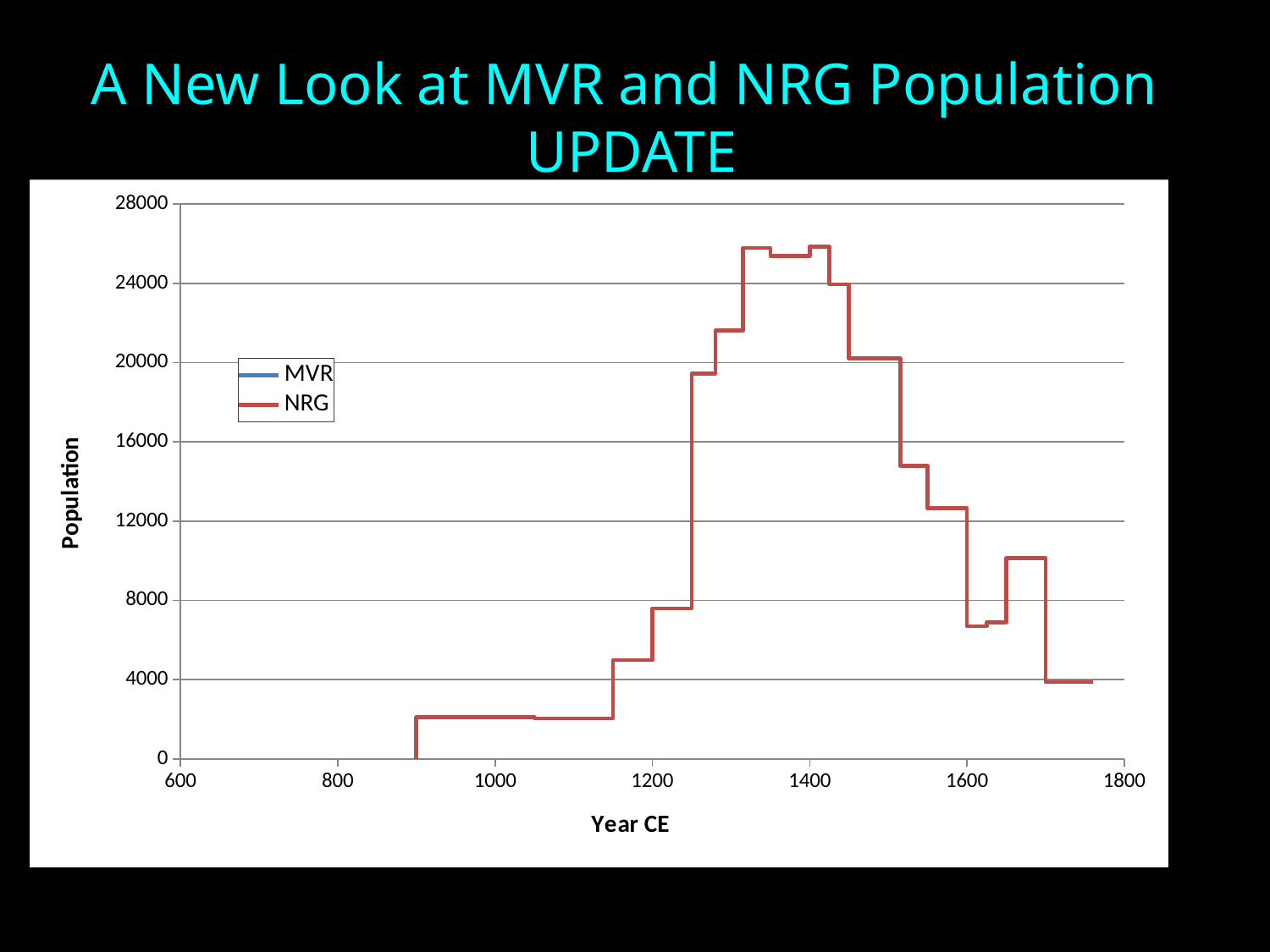
Does the NRG population rise or fall between the years 1420 and 1620? fall Does the NRG population rise or fall between the years 900 and 1350? rise What kind of chart is shown on the slide? line chart How many series does the legend list? 2 Is the NRG population higher around the year 1300 or around the year 1600? 1300 Is the NRG population around the year 1620 greater or less than 8000? less Is the NRG population around the year 1300 greater or less than 20000? greater What is the label of the x axis? Year CE Is the NRG population around the year 1350 greater or less than 24000? greater What are the two series named in the legend? MVR and NRG